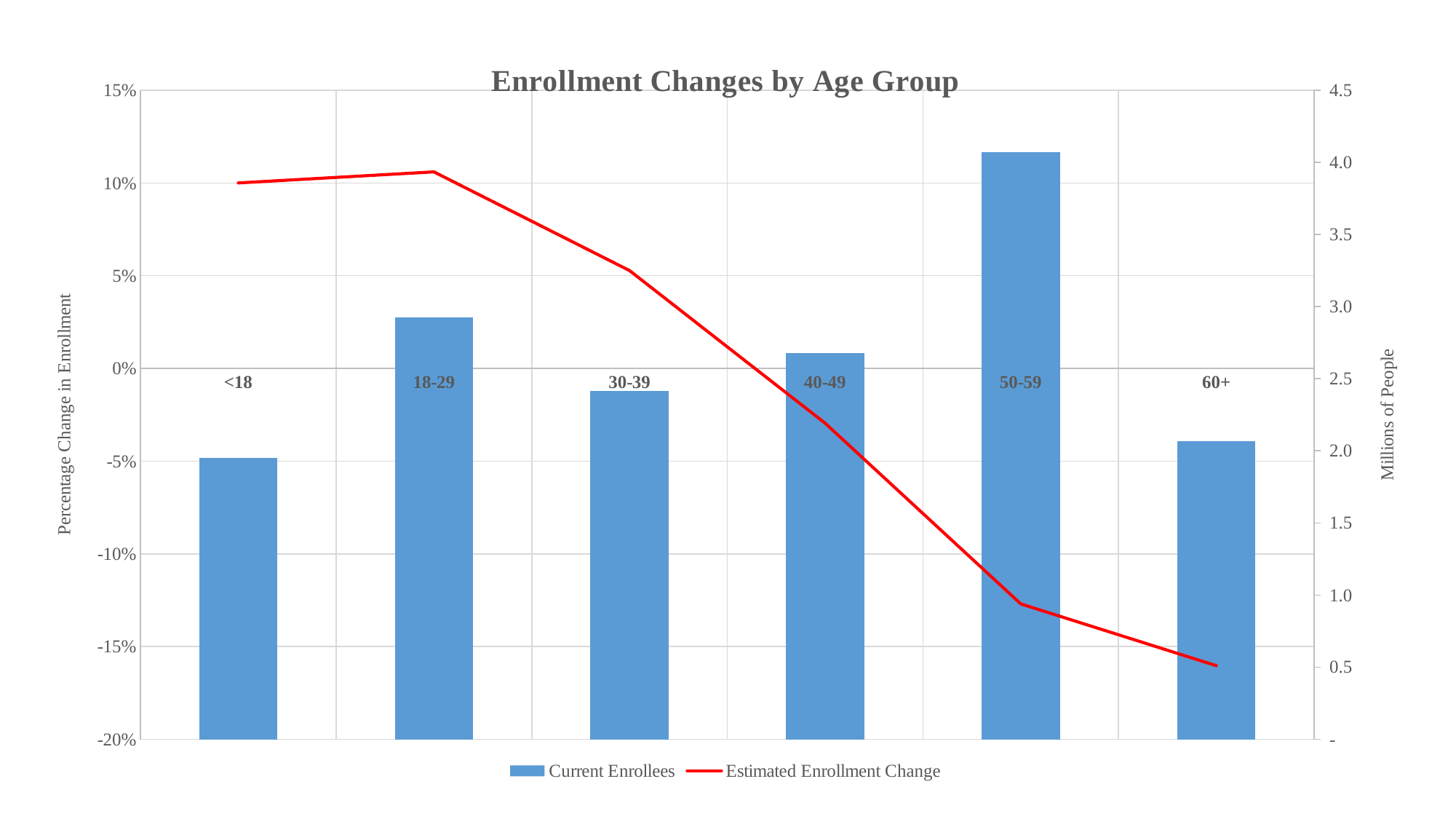
How many age groups are shown on the x axis? 6 Which age group has the highest Current Enrollees bar? 50-59 Which age group has the lowest value on the Estimated Enrollment Change line? 60+ What kind of chart is this? Combined bar and line chart How many series does the legend list? 2 Does the Estimated Enrollment Change line generally rise or fall from <18 to 60+? fall What is the title of the chart? Enrollment Changes by Age Group Which has the larger Current Enrollees value, 18-29 or 40-49? 18-29